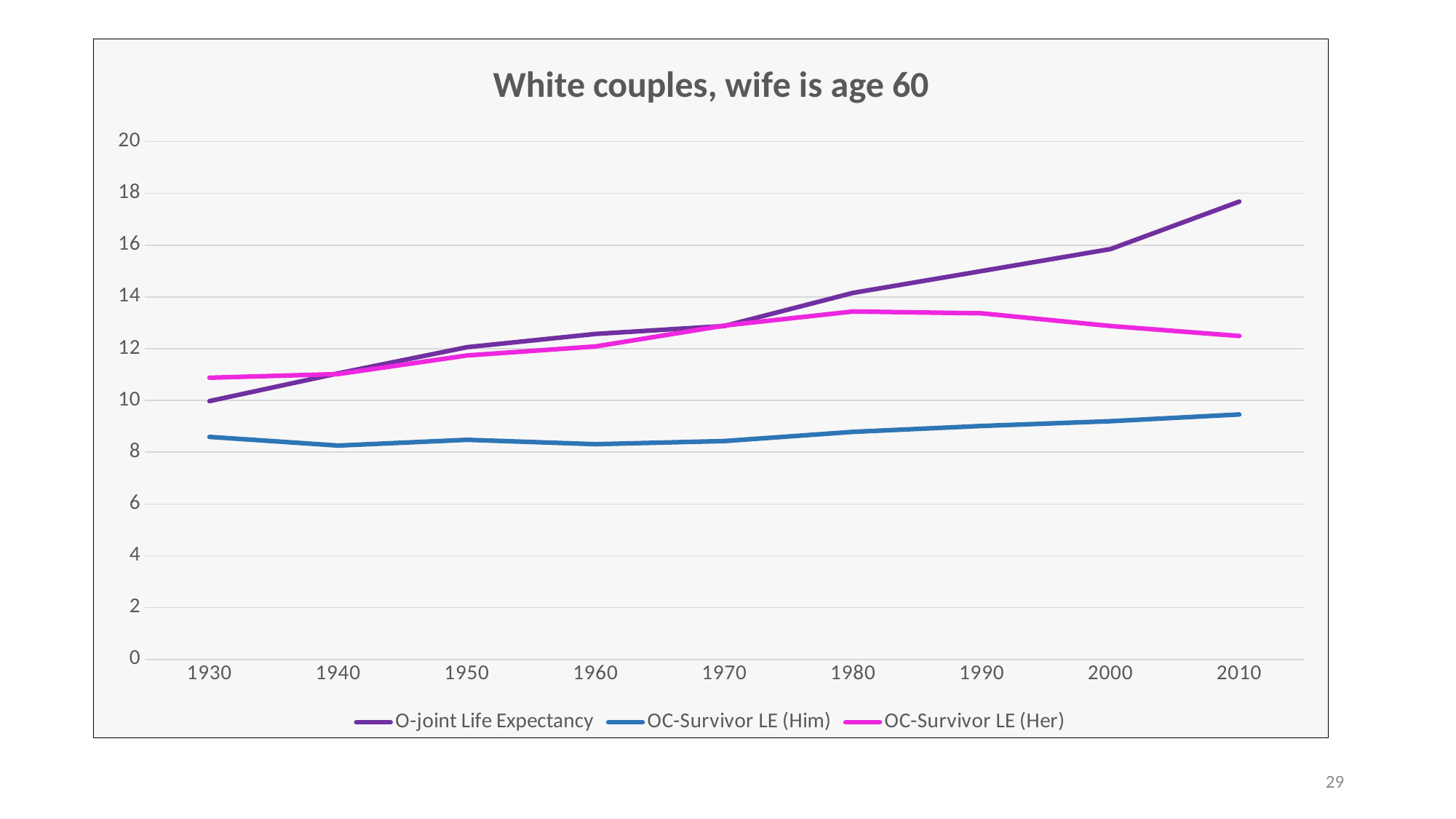
In 1930, which is larger: OC-Survivor LE (Her) or O-joint Life Expectancy? OC-Survivor LE (Her) How many series does the legend list? 3 What is the title of the chart? White couples, wife is age 60 How many years are marked along the x axis? 9 Which series has the lowest value in 1960? OC-Survivor LE (Him) Does the O-joint Life Expectancy line rise or fall from 1930 to 2010? rise What kind of chart is shown on the slide? line chart In 2010, which is larger: O-joint Life Expectancy or OC-Survivor LE (Her)? O-joint Life Expectancy Which series has the highest value in 2010? O-joint Life Expectancy Is the value for O-joint Life Expectancy in 2010 greater or less than 16? greater Is the value for OC-Survivor LE (Him) in 1930 greater or less than 10? less Is the value for OC-Survivor LE (Her) in 1980 greater or less than 12? greater